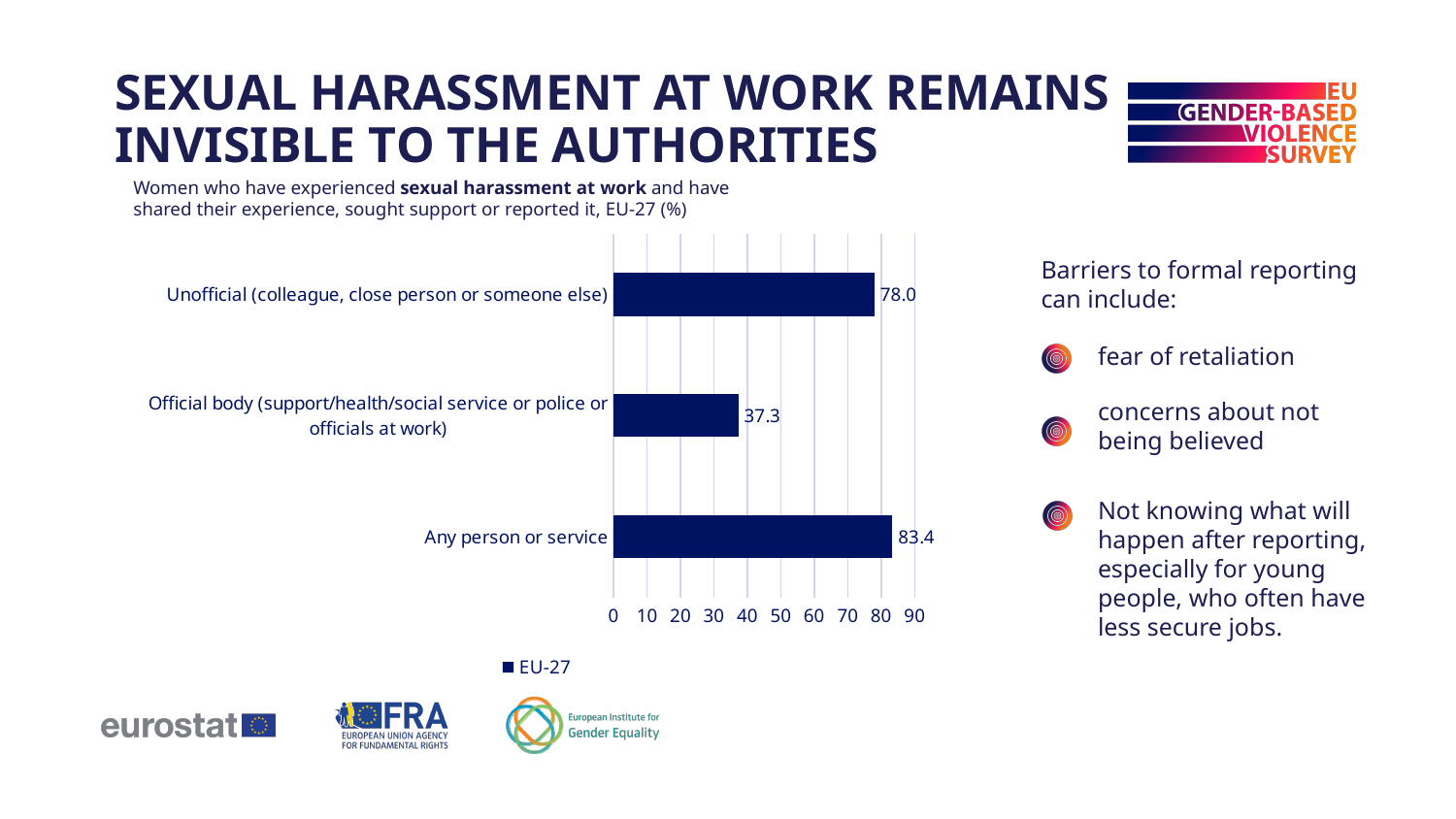
What kind of chart is shown on the slide? Bar chart How many categories are shown in the chart? 3 How many series does the legend list? 1 What is the value for 'Official body (support/health/social service or police or officials at work)'? 37.3 Which is larger: the value for 'Unofficial (colleague, close person or someone else)' or for 'Any person or service'? Any person or service What is the difference between the values for 'Any person or service' and 'Official body (support/health/social service or police or officials at work)'? 46.1 What is the value for 'Any person or service'? 83.4 What is the difference between the values for 'Unofficial (colleague, close person or someone else)' and 'Official body (support/health/social service or police or officials at work)'? 40.7 Which category has the highest value? Any person or service What is the value for 'Unofficial (colleague, close person or someone else)'? 78.0 Is the value for 'Official body (support/health/social service or police or officials at work)' greater or less than 40? less Which category has the lowest value? Official body (support/health/social service or police or officials at work)